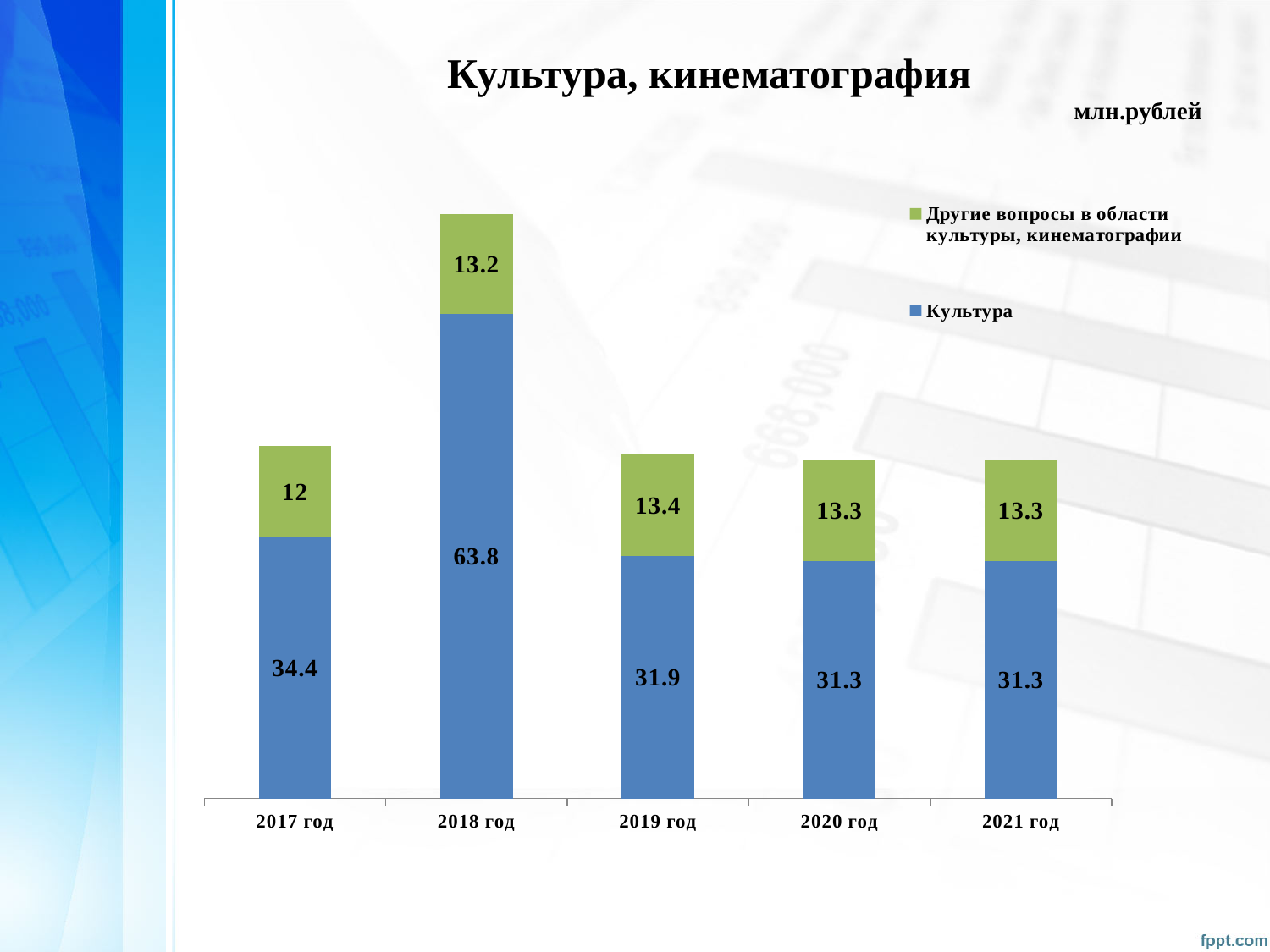
What unit is indicated for the chart values? млн.рублей What is the value for Культура in 2019 год? 31.9 What is the value for Культура in 2018 год? 63.8 What is the difference between the Культура values for 2018 год and 2017 год? 29.4 In which year is the value for Культура the highest? 2018 год What is the value for Другие вопросы в области культуры, кинематографии in 2017 год? 12 What type of chart is shown on the slide? Stacked bar chart How many series does the legend list? 2 What is the total of the stacked bar for 2018 год? 77 How many years are shown on the x axis? 5 Which is larger: the Культура value in 2017 год or in 2019 год? 2017 год In which year is the value for Другие вопросы в области культуры, кинематографии the lowest? 2017 год